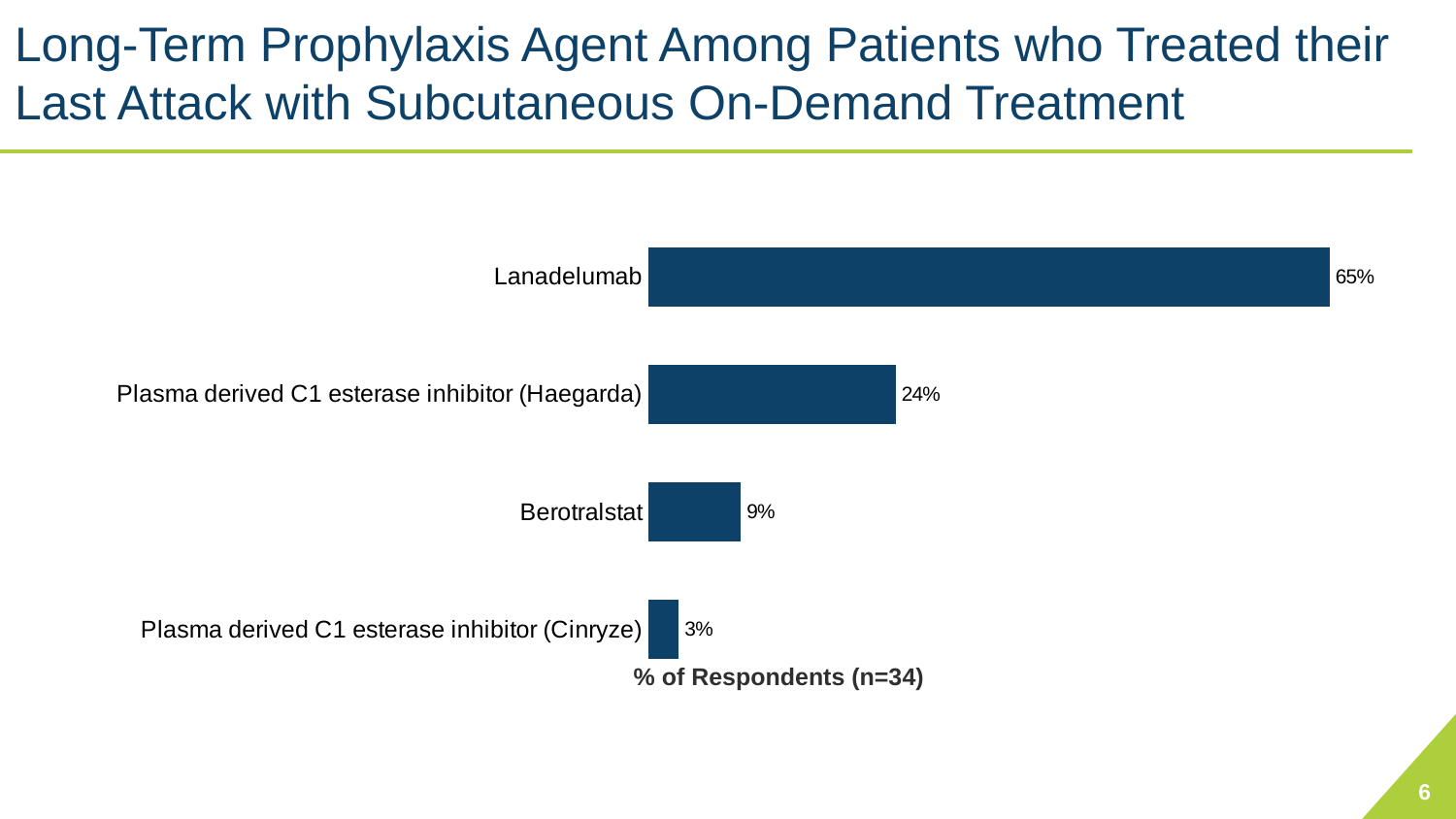
What is the difference in percentage points between Lanadelumab and Plasma derived C1 esterase inhibitor (Haegarda)? 41 percentage points What percentage of respondents use Lanadelumab as their long-term prophylaxis agent? 65% Which long-term prophylaxis agent has the highest percentage of respondents? Lanadelumab Which has a larger share of respondents, Berotralstat or Plasma derived C1 esterase inhibitor (Haegarda)? Plasma derived C1 esterase inhibitor (Haegarda) What type of chart is shown on the slide? Bar chart How many respondents (n) does the chart's axis label indicate? 34 What is the value for Plasma derived C1 esterase inhibitor (Haegarda)? 24% How many long-term prophylaxis agents are shown in the chart? 4 What is the difference in percentage points between Berotralstat and Plasma derived C1 esterase inhibitor (Cinryze)? 6 percentage points Which long-term prophylaxis agent has the lowest percentage of respondents? Plasma derived C1 esterase inhibitor (Cinryze) What percentage of respondents use Berotralstat? 9% What is the value for Plasma derived C1 esterase inhibitor (Cinryze)? 3%